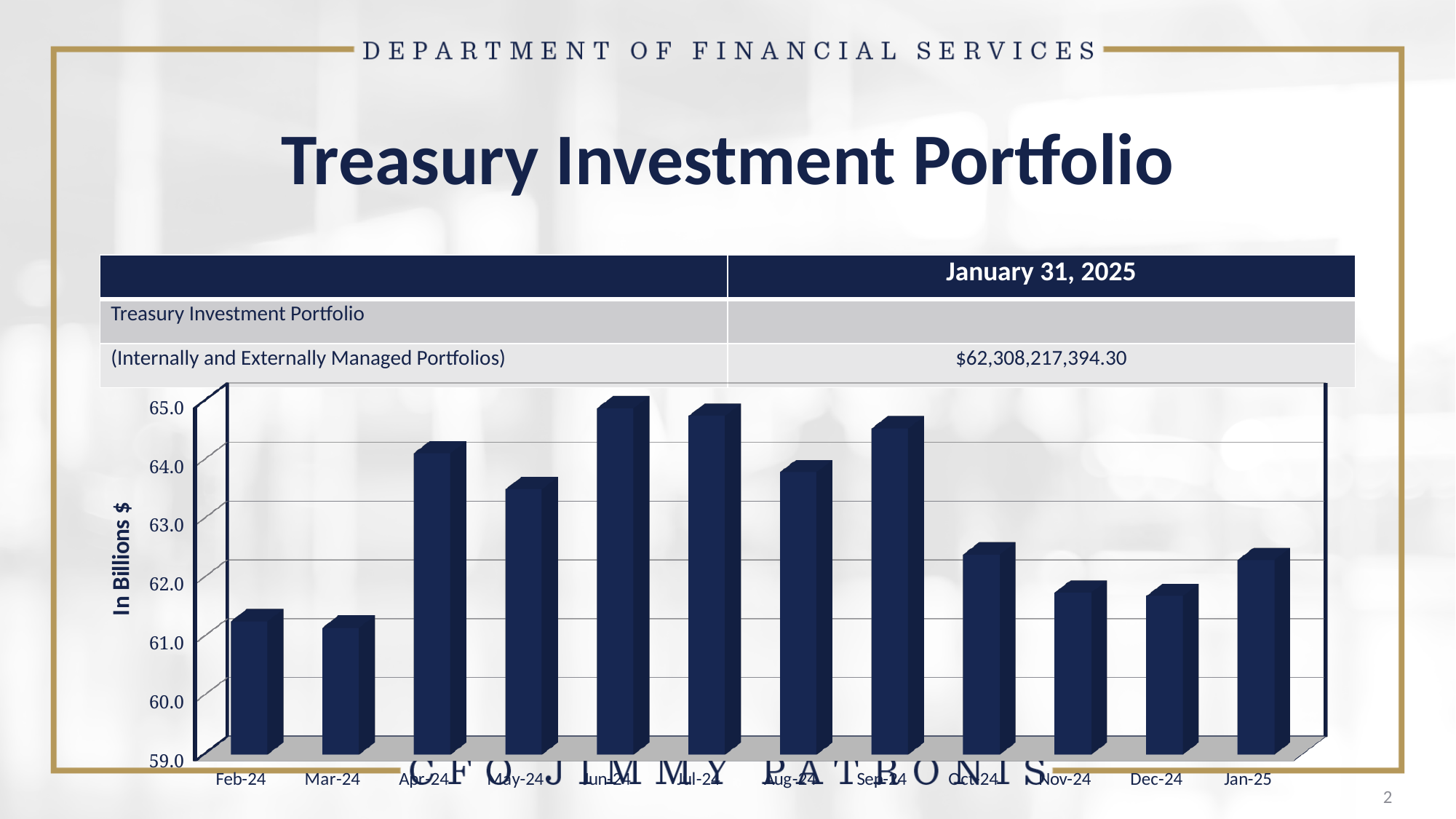
What kind of chart is shown on the slide? bar chart Which is larger, the value for Apr-24 or the value for Feb-24? Apr-24 Is the value for Jun-24 greater or less than 64.0? greater Is the value for Sep-24 greater or less than 64.0? greater Is the value for May-24 greater or less than 63.0? greater What is the title of the slide containing the chart? Treasury Investment Portfolio Which is larger, the value for Oct-24 or the value for Nov-24? Oct-24 Do the values rise or fall from Jun-24 to Dec-24? fall How many months are plotted on the chart? 12 What is the label on the vertical axis of the chart? In Billions $